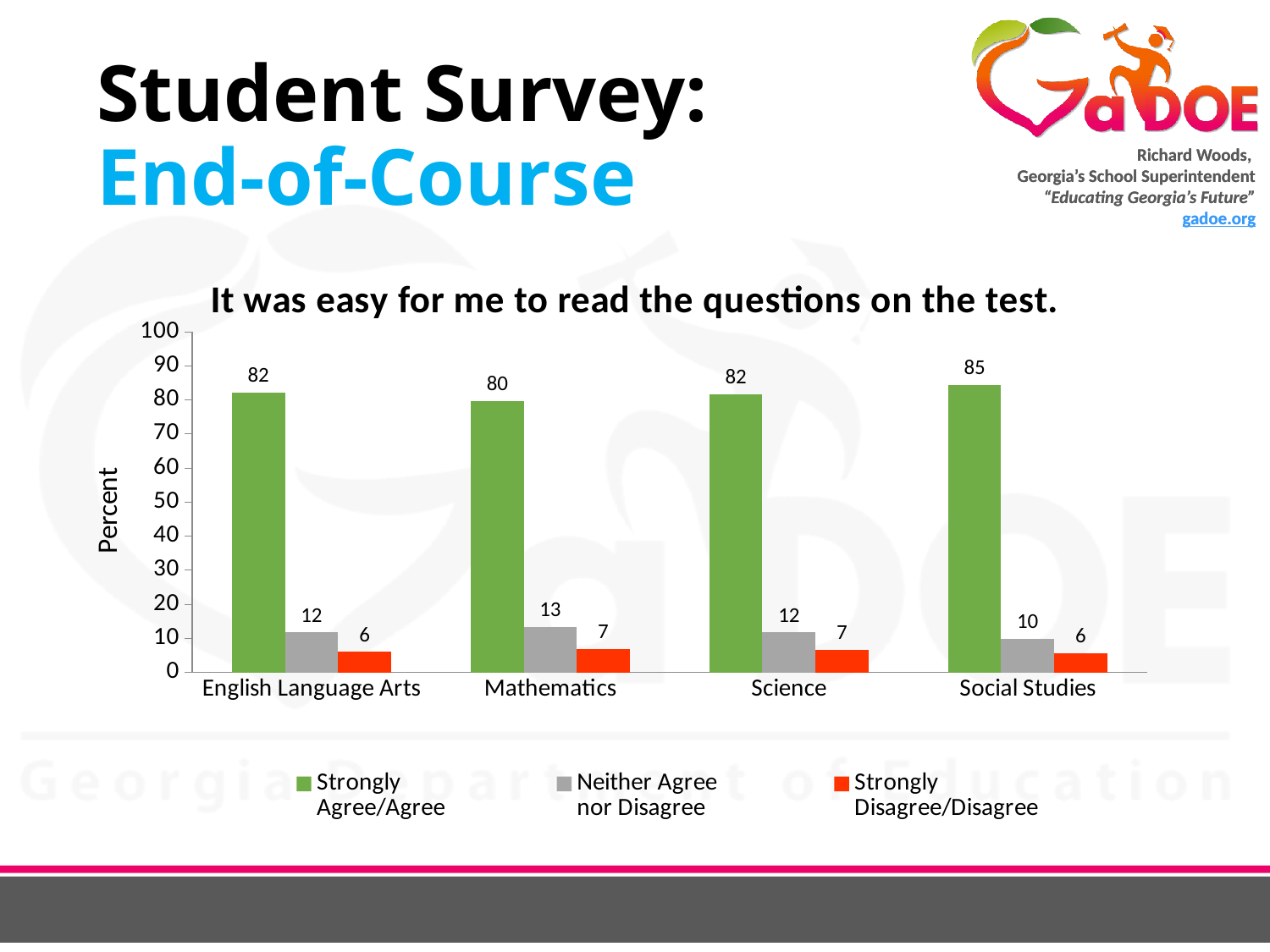
Which subject has the lowest Strongly Agree/Agree value? Mathematics What kind of chart is shown on the slide? bar chart What is the Strongly Disagree/Disagree value for Science? 7 Which subject has the highest Strongly Agree/Agree value? Social Studies How many series does the legend list? 3 Is the Strongly Agree/Agree value for English Language Arts greater or less than 70? greater What is the title of the chart? It was easy for me to read the questions on the test. How many subjects are shown on the x axis? 4 Which is larger, the Neither Agree nor Disagree value for Mathematics or for Social Studies? Mathematics What is the difference between the Strongly Agree/Agree values for Social Studies and Mathematics? 5 What is the Strongly Agree/Agree value for Social Studies? 85 What is the Neither Agree nor Disagree value for Mathematics? 13